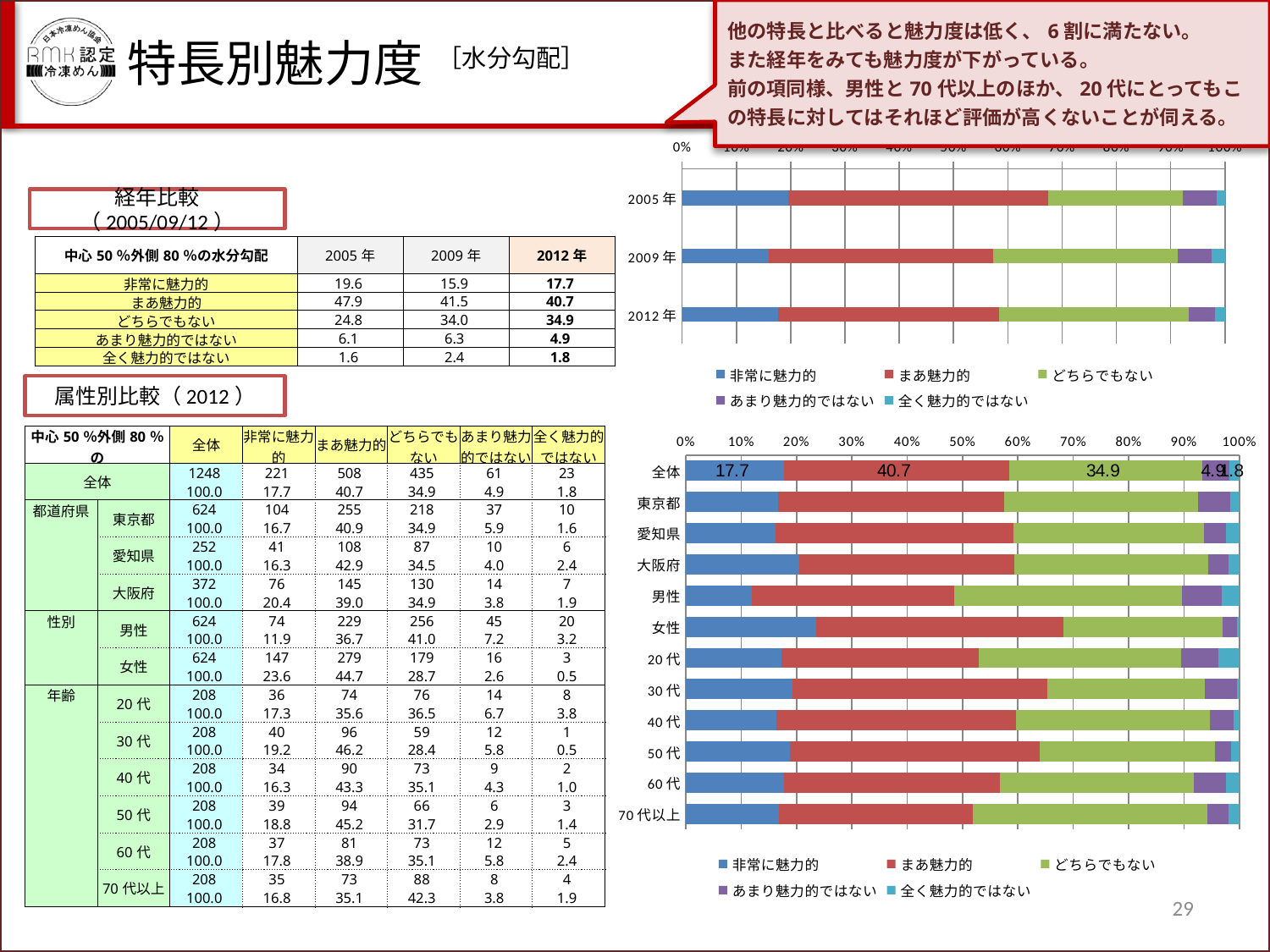
In the lower chart (属性別比較 2012), what is the total of the 全体 bar? 100 What kind of chart is the lower chart (属性別比較 2012)? Stacked horizontal bar chart In the lower chart (属性別比較 2012), what is the value of 非常に魅力的 for 全体? 17.7 How many series does the legend of the lower chart (属性別比較 2012) list? 5 In the lower chart (属性別比較 2012), what is the value of どちらでもない for 全体? 34.9 How many categories are plotted in the upper chart (経年比較)? 3 In the lower chart (属性別比較 2012), which category has the longest 非常に魅力的 segment? 女性 In the lower chart (属性別比較 2012), is the 非常に魅力的 segment for 女性 greater or less than 20%? greater How many categories are plotted in the lower chart (属性別比較 2012)? 12 In the upper chart (経年比較), is the 非常に魅力的 segment for 2009年 greater or less than 20%? less In the lower chart (属性別比較 2012), is the 非常に魅力的 segment for 男性 greater or less than 20%? less In the lower chart (属性別比較 2012), what is the value of まあ魅力的 for 全体? 40.7